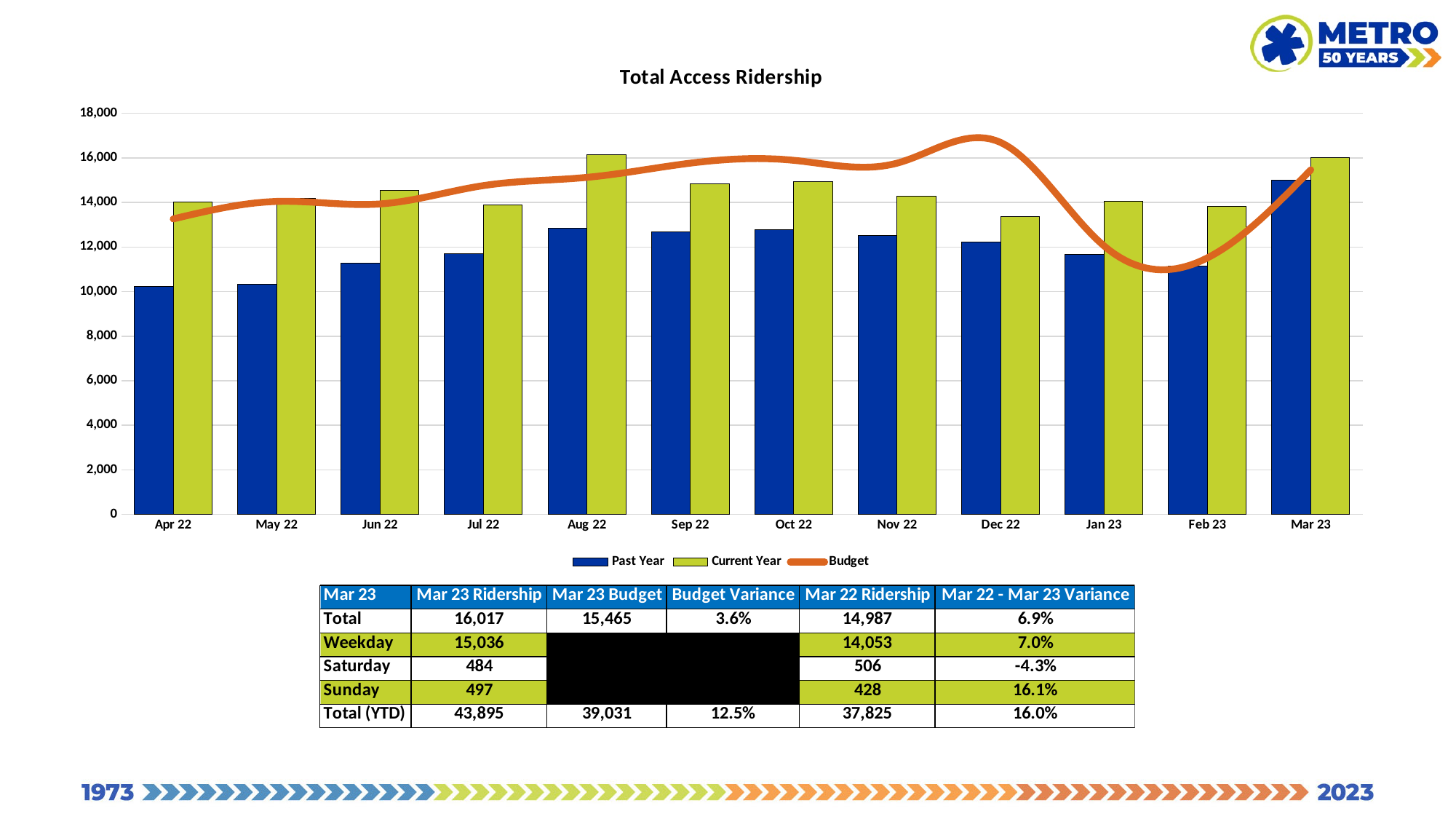
How many months are shown on the x axis of the chart? 12 For Jan 23, which is larger, the Current Year value or the Budget value? Current Year Is the Current Year value for Dec 22 greater or less than 14,000? less How many series does the chart legend list? 3 What is the Past Year ridership value for Mar 23? 14,987 What is the Budget value for Mar 23? 15,465 What kind of chart is shown on the slide? Bar chart with a line series Which month has the lowest Current Year value? Dec 22 What is the Current Year ridership value for Mar 23? 16,017 What is the title of the chart? Total Access Ridership What is the difference between the Current Year and Past Year values for Mar 23? 1,030 Which month has the highest Past Year value? Mar 23